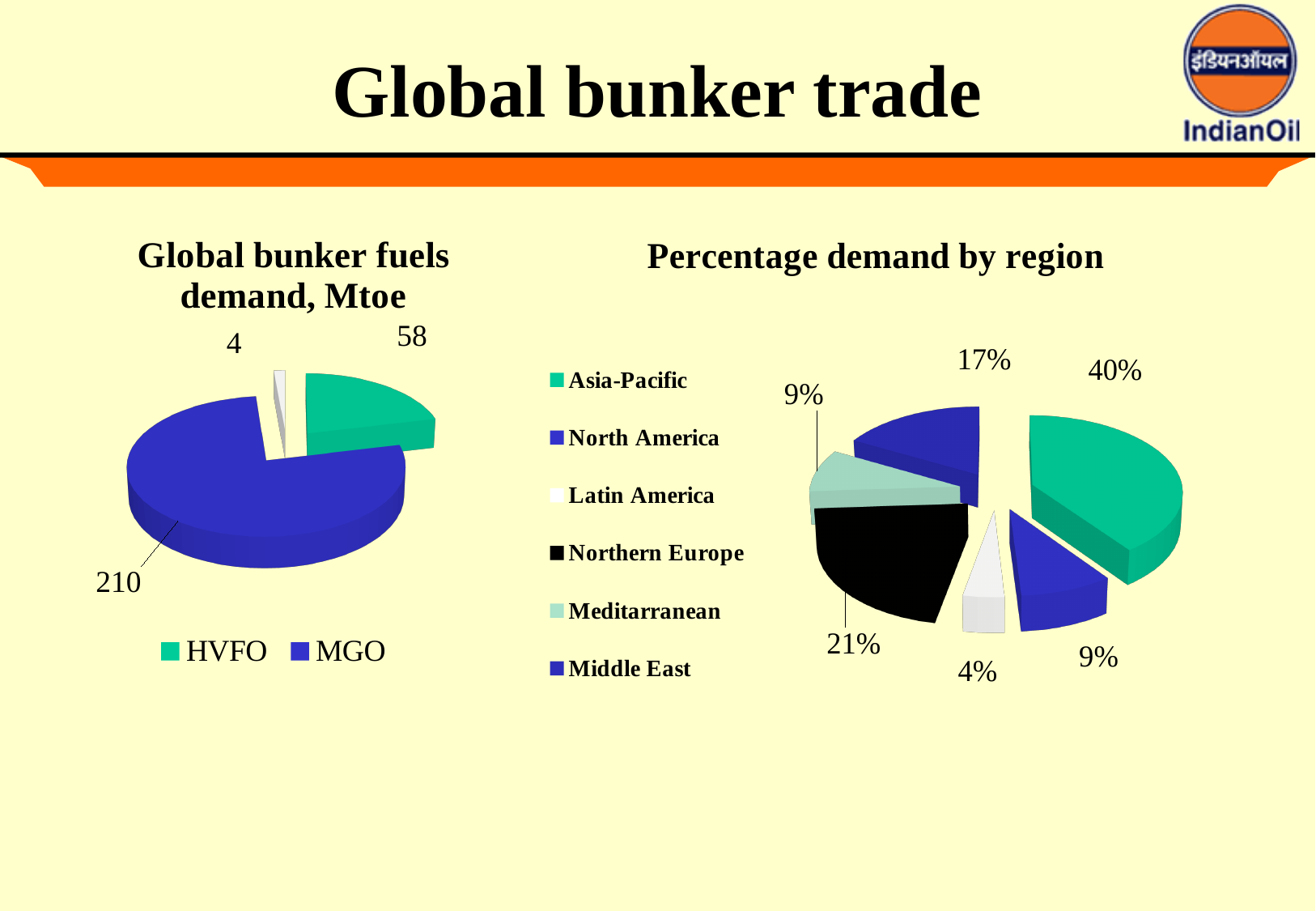
In the 'Global bunker fuels demand, Mtoe' chart, what is the value for HVFO? 58 In the 'Global bunker fuels demand, Mtoe' chart, what is the difference between the MGO and HVFO values? 152 In the 'Percentage demand by region' chart, what share does Asia-Pacific have? 40% In the 'Percentage demand by region' chart, which region has the smallest share? Latin America How many regions are listed in the legend of the 'Percentage demand by region' chart? 6 In the 'Global bunker fuels demand, Mtoe' chart, what is the value for MGO? 210 In the 'Percentage demand by region' chart, what share does Middle East have? 17% What kind of chart is the 'Global bunker fuels demand, Mtoe' chart? Pie chart In the 'Global bunker fuels demand, Mtoe' chart, which is larger, HVFO or MGO? MGO In the 'Percentage demand by region' chart, which region has the largest share? Asia-Pacific In the 'Percentage demand by region' chart, what share does Northern Europe have? 21% In the 'Percentage demand by region' chart, what colour represents Northern Europe? Black